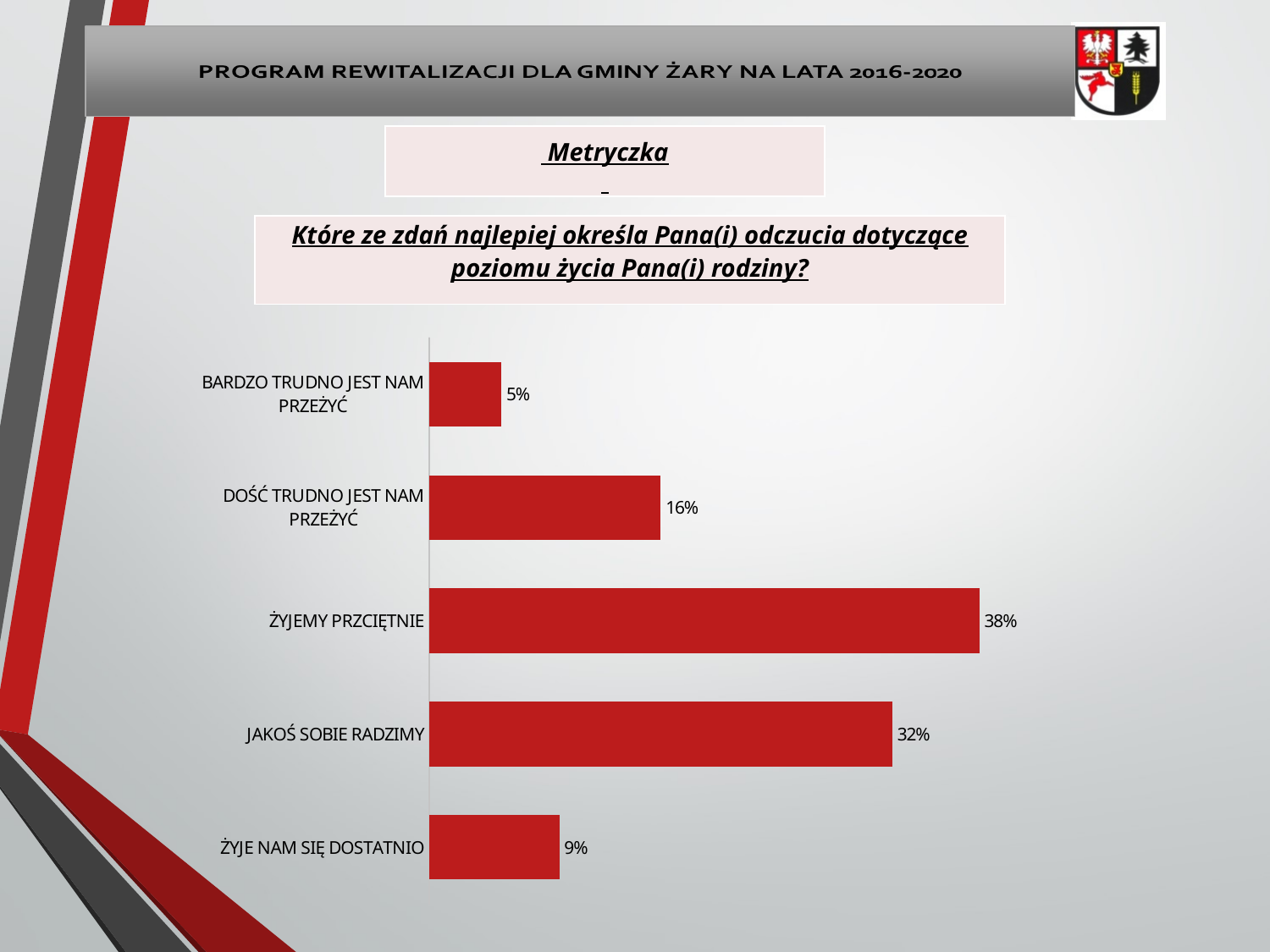
What colour are the bars in the chart? Red How many categories are shown in the chart? 5 What is the value for BARDZO TRUDNO JEST NAM PRZEŻYĆ? 5% What is the difference between the values for DOŚĆ TRUDNO JEST NAM PRZEŻYĆ and ŻYJE NAM SIĘ DOSTATNIO? 7% What is the value for ŻYJE NAM SIĘ DOSTATNIO? 9% What is the difference between the values for ŻYJEMY PRZCIĘTNIE and JAKOŚ SOBIE RADZIMY? 6% What kind of chart is shown on the slide? Bar chart Which category has the highest value? ŻYJEMY PRZCIĘTNIE What is the value for ŻYJEMY PRZCIĘTNIE? 38% What is the value for JAKOŚ SOBIE RADZIMY? 32% Which category has the lowest value? BARDZO TRUDNO JEST NAM PRZEŻYĆ Which is larger, the value for DOŚĆ TRUDNO JEST NAM PRZEŻYĆ or the value for ŻYJE NAM SIĘ DOSTATNIO? DOŚĆ TRUDNO JEST NAM PRZEŻYĆ